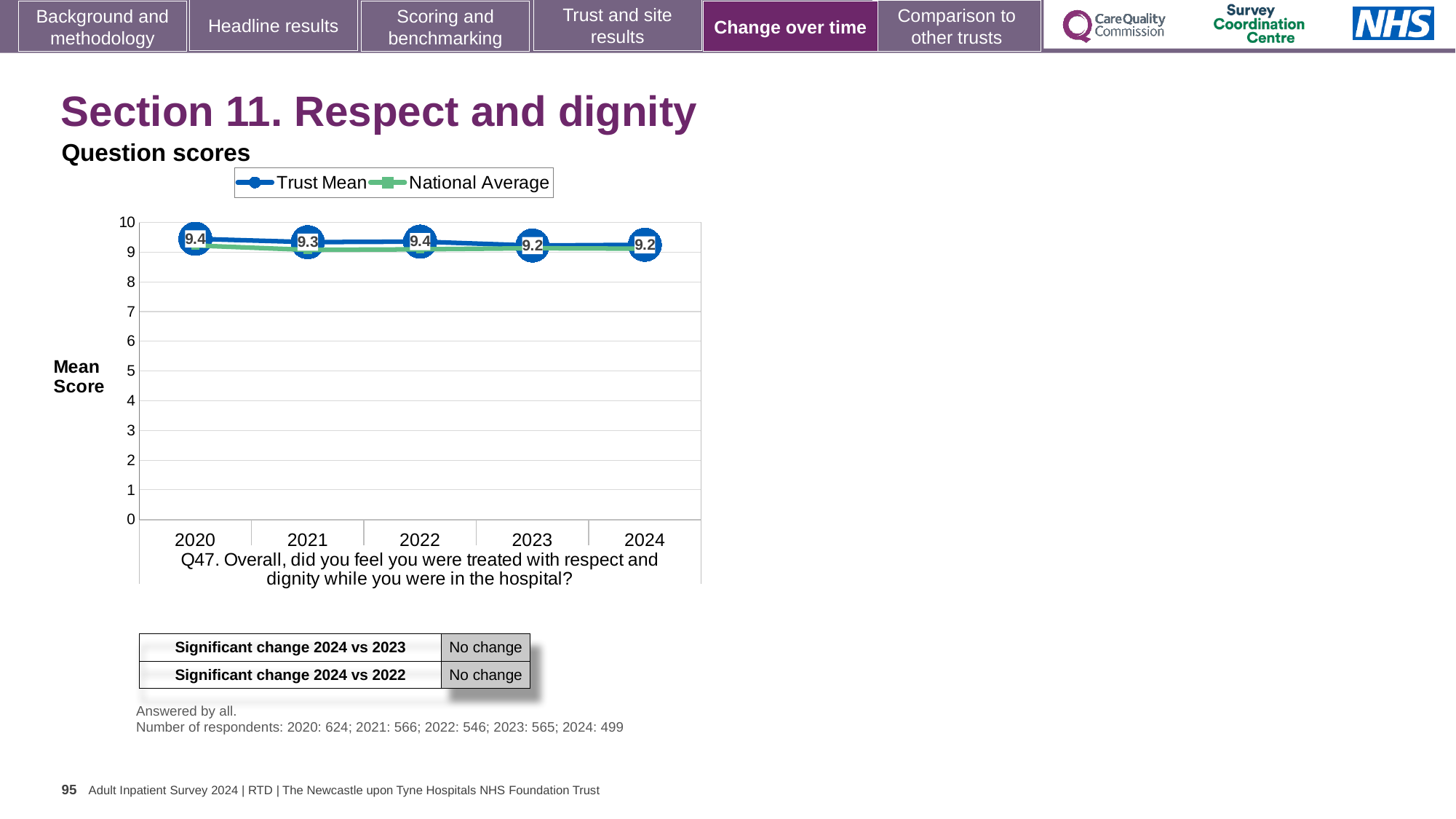
What is the Trust Mean value for 2023? 9.2 What is the Trust Mean value for 2020? 9.4 Which year has the larger Trust Mean, 2022 or 2023? 2022 Does the Trust Mean rise or fall overall from 2020 to 2024? Fall How many years are plotted on the x axis? 5 What kind of chart is shown on the slide? Line chart What is the label on the y axis of the chart? Mean Score What is the Trust Mean value for 2024? 9.2 How many series does the legend list? 2 What is the Trust Mean value for 2021? 9.3 What is the difference between the Trust Mean in 2020 and in 2024? 0.2 Is the National Average value for 2021 greater or less than 8? greater